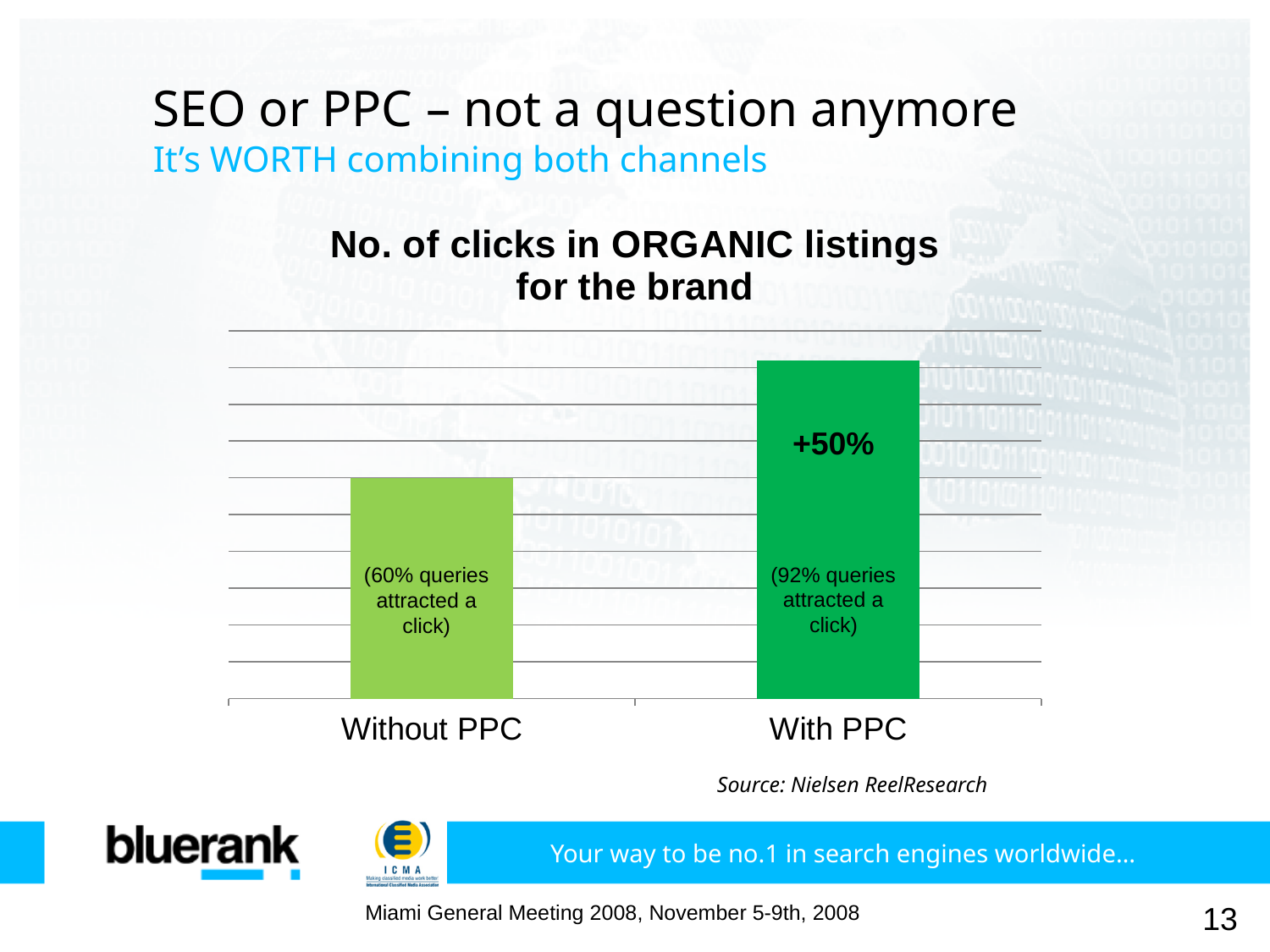
Which category has the lowest number of clicks in organic listings? Without PPC Do the bars rise or fall moving from Without PPC to With PPC along the x axis? rise What percentage of queries attracted a click in the With PPC bar? 92% What source is cited below the chart? Nielsen ReelResearch By how many percentage points does the share of queries attracting a click differ between With PPC (92%) and Without PPC (60%)? 32 percentage points Which category has the taller bar, Without PPC or With PPC? With PPC What is the title of the chart? No. of clicks in ORGANIC listings for the brand Which category has the highest number of clicks in organic listings? With PPC What kind of chart is shown on the slide? bar chart How many categories are plotted in the chart? 2 What percentage of queries attracted a click in the Without PPC bar? 60% What percentage increase is labelled on the With PPC bar? +50%